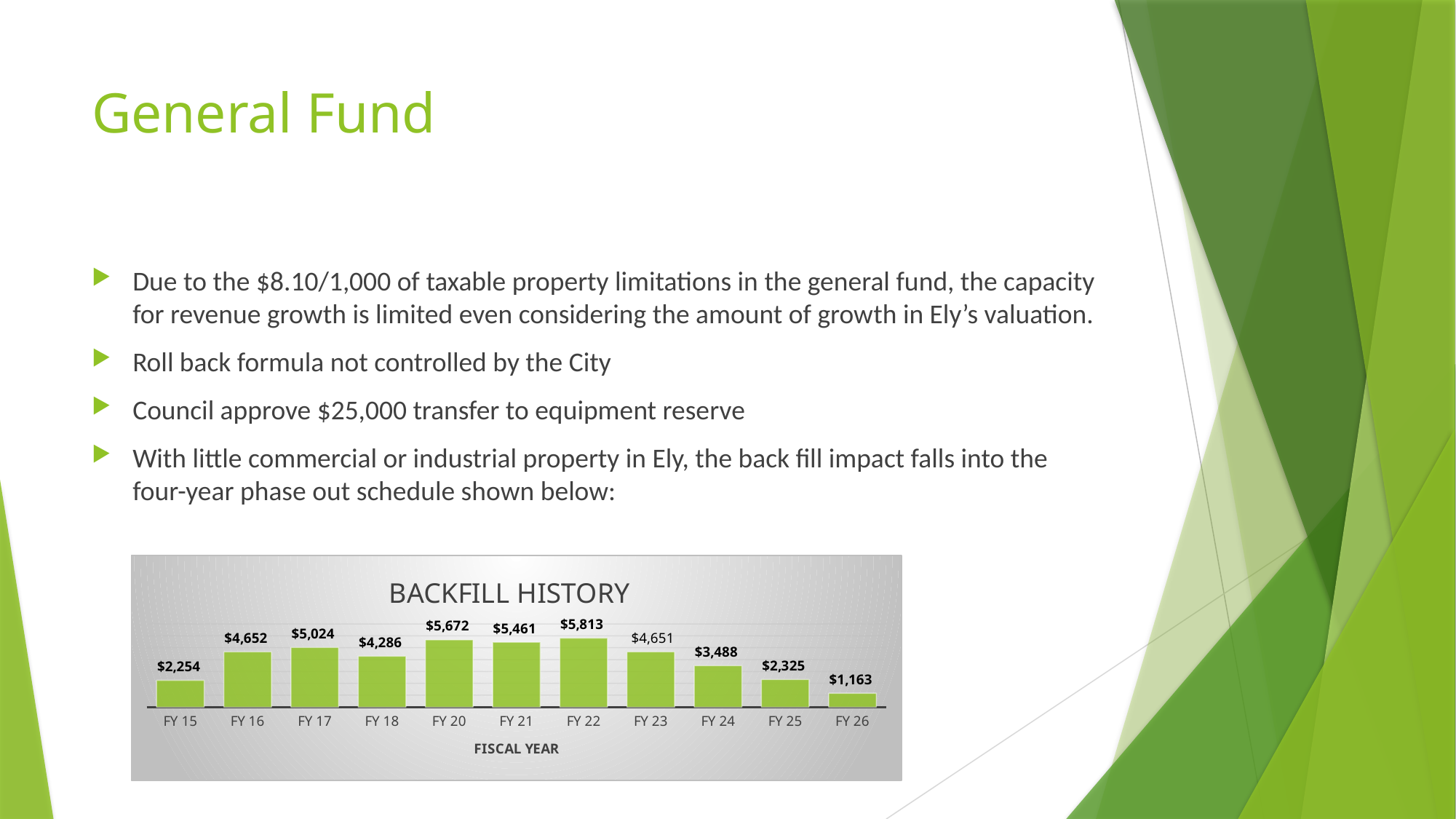
What kind of chart is the Backfill History chart? Bar chart In the Backfill History chart, which is larger, the value for FY 17 or the value for FY 18? FY 17 What is the value for FY 24 in the Backfill History chart? $3,488 What is the difference between the FY 20 and FY 21 values in the Backfill History chart? $211 What is the x-axis title of the Backfill History chart? FISCAL YEAR What is the value for FY 22 in the Backfill History chart? $5,813 What is the value for FY 15 in the Backfill History chart? $2,254 How many fiscal years are shown in the Backfill History chart? 11 In the Backfill History chart, do the values rise or fall from FY 22 to FY 26? Fall Which fiscal year has the lowest value in the Backfill History chart? FY 26 What is the difference between the FY 22 and FY 26 values in the Backfill History chart? $4,650 Which fiscal year has the highest value in the Backfill History chart? FY 22